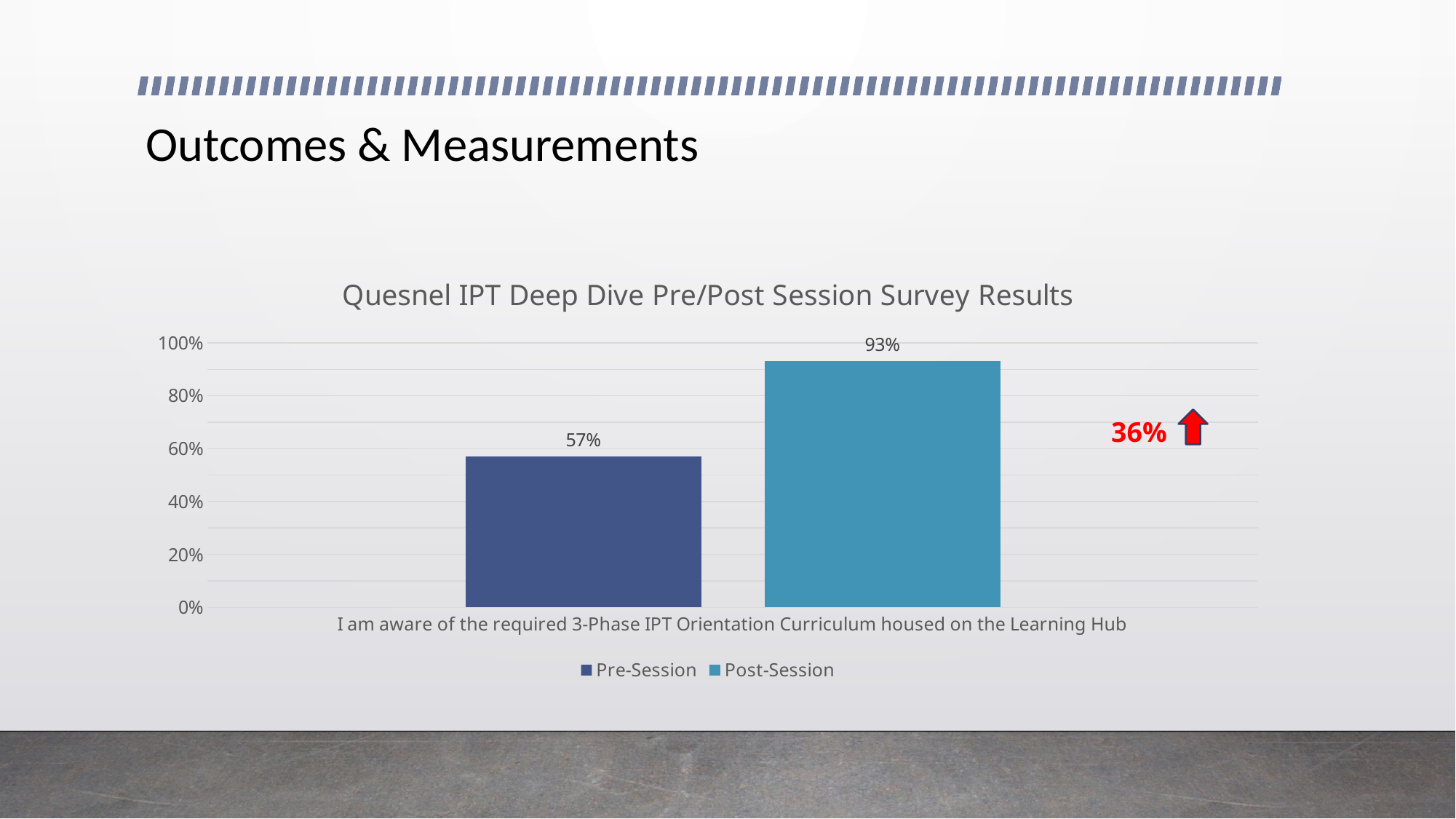
What is the Post-Session value shown on the chart? 93% What is the difference between the Post-Session and Pre-Session values? 36% Is the Pre-Session value greater or less than 60%? less Which series has the higher value, Pre-Session or Post-Session? Post-Session How many categories are shown on the x axis? 1 How many series does the legend list? 2 What is the category label on the x axis? I am aware of the required 3-Phase IPT Orientation Curriculum housed on the Learning Hub What kind of chart is shown on the slide? Bar chart What is the Pre-Session value shown on the chart? 57% What is the title of the chart? Quesnel IPT Deep Dive Pre/Post Session Survey Results Is the Post-Session value greater or less than 80%? greater Which series has the lowest value on the chart? Pre-Session